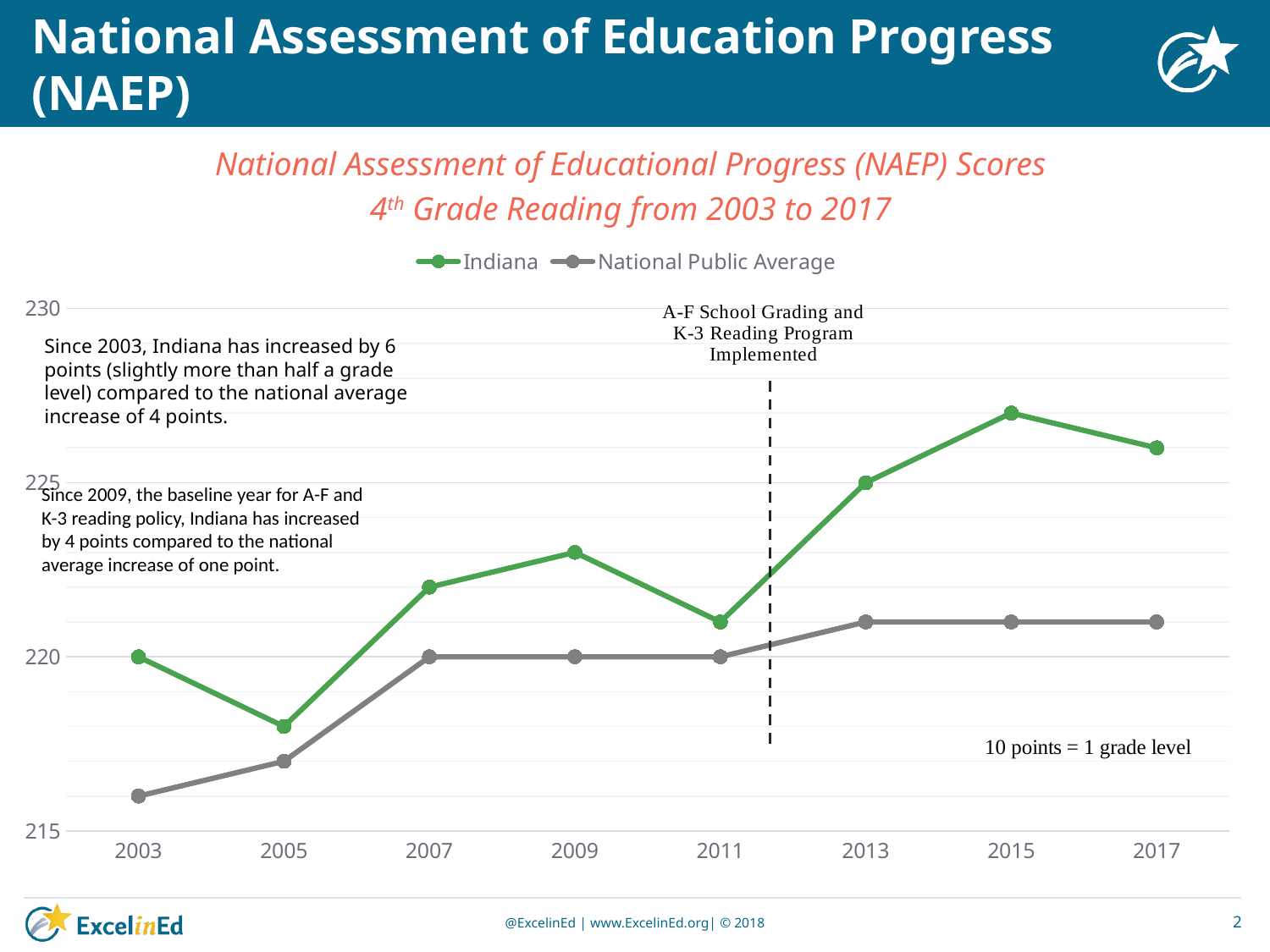
Is Indiana's score in 2015 greater or less than 225? greater Does Indiana's score rise or fall from 2003 to 2005? fall What was the National Public Average score in 2009? 220 In which year was Indiana's score highest? 2015 Is the National Public Average score in 2003 greater or less than 220? less What was Indiana's score in 2013? 225 In 2017, which series has the higher score, Indiana or National Public Average? Indiana How many years are plotted along the x axis? 8 What was Indiana's score in 2003? 220 In which year was Indiana's score lowest? 2005 How many series does the legend list? 2 What kind of chart is shown on the slide? Line chart